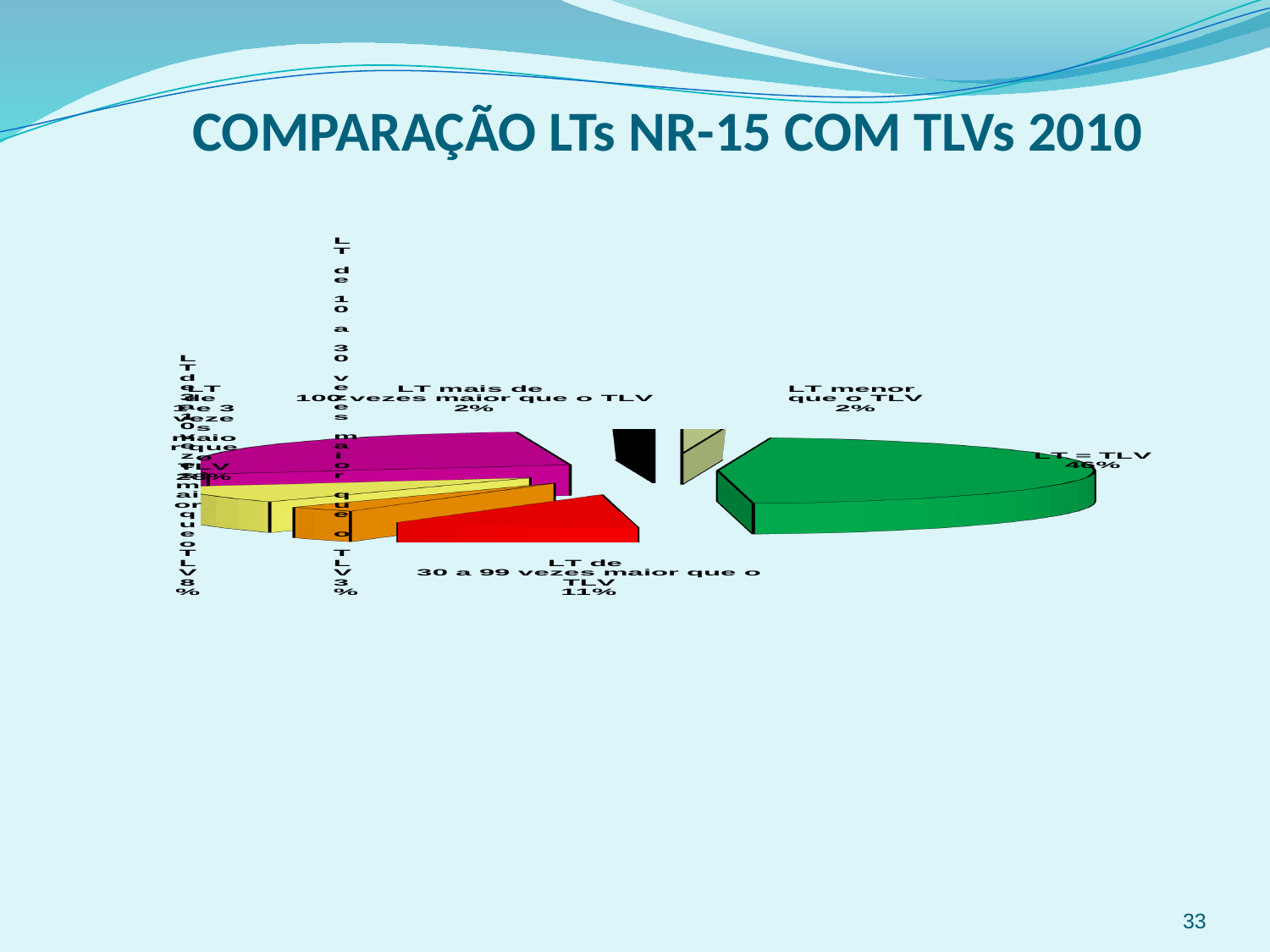
What share of the pie is labelled "LT = TLV"? 46% Which category has the largest slice of the pie? LT = TLV What percentage is shown for "LT menor que o TLV"? 2% What is the title of the slide containing the pie chart? COMPARAÇÃO LTs NR-15 COM TLVs 2010 Which is larger: the slice for "LT = TLV" or the slice for "LT de 30 a 99 vezes maior que o TLV"? LT = TLV What kind of chart is shown on the slide? pie chart What percentage is shown for "LT de 30 a 99 vezes maior que o TLV"? 11% What is the difference in percentage points between "LT de 30 a 99 vezes maior que o TLV" (11%) and "LT menor que o TLV" (2%)? 9 percentage points What is the difference in percentage points between "LT = TLV" (46%) and "LT de 30 a 99 vezes maior que o TLV" (11%)? 35 percentage points What percentage is shown for "LT mais de 100 vezes maior que o TLV"? 2% How many slices does the pie chart have? 7 What colour is the slice labelled "LT = TLV"? green